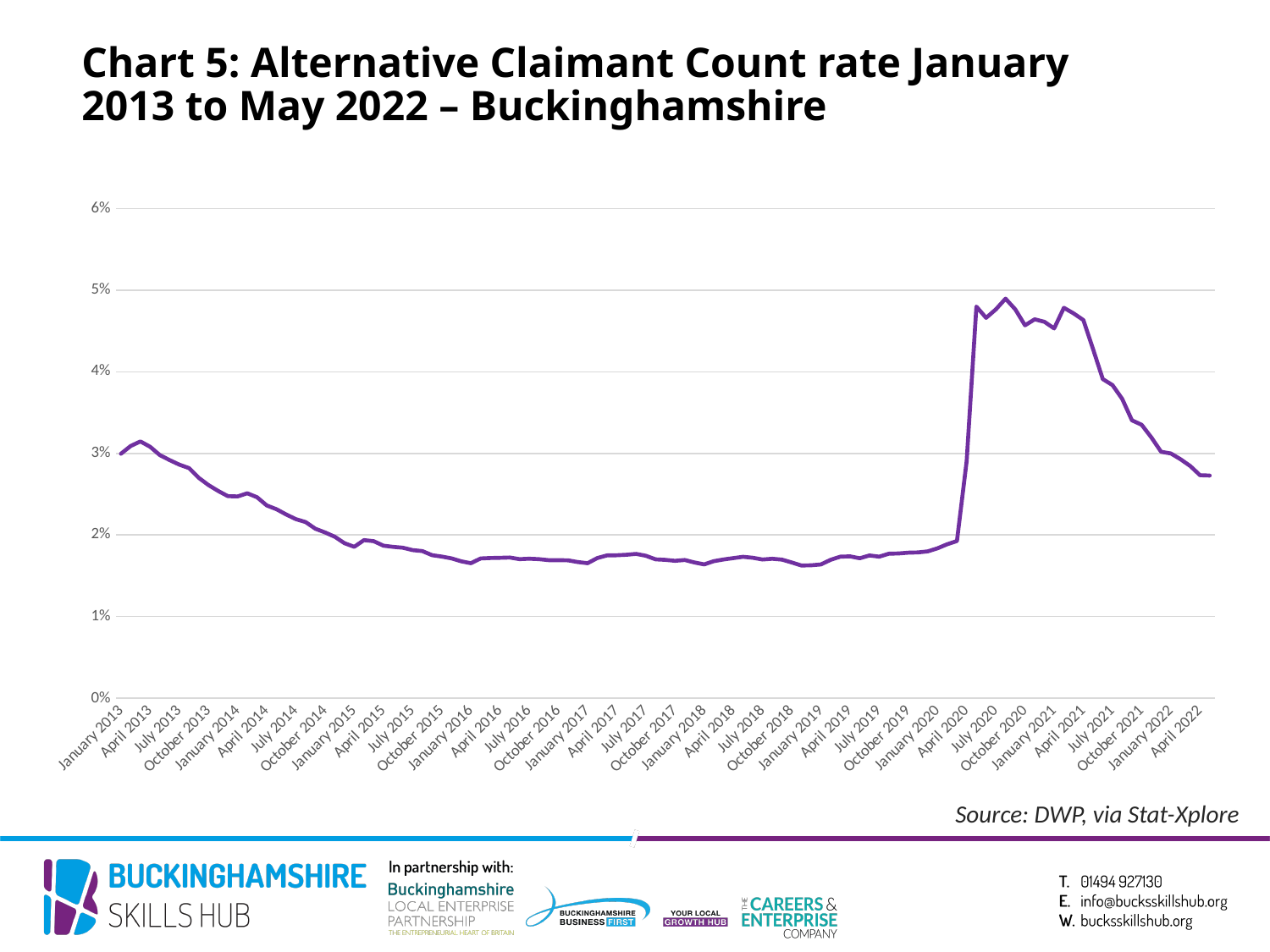
Is the value for January 2016 greater or less than 2%? less Does the claimant count rate rise or fall between July 2020 and April 2022? Fall Does the claimant count rate rise or fall between January 2013 and January 2016? Fall Is the value for April 2022 greater or less than 3%? less What is the title of the chart? Chart 5: Alternative Claimant Count rate January 2013 to May 2022 – Buckinghamshire Which is larger, the value for January 2020 or the value for July 2020? July 2020 Is the value for January 2014 greater or less than 3%? less What kind of chart is shown on the slide? Line chart What source is cited for the chart data? DWP, via Stat-Xplore In which year does the line reach its highest value? 2020